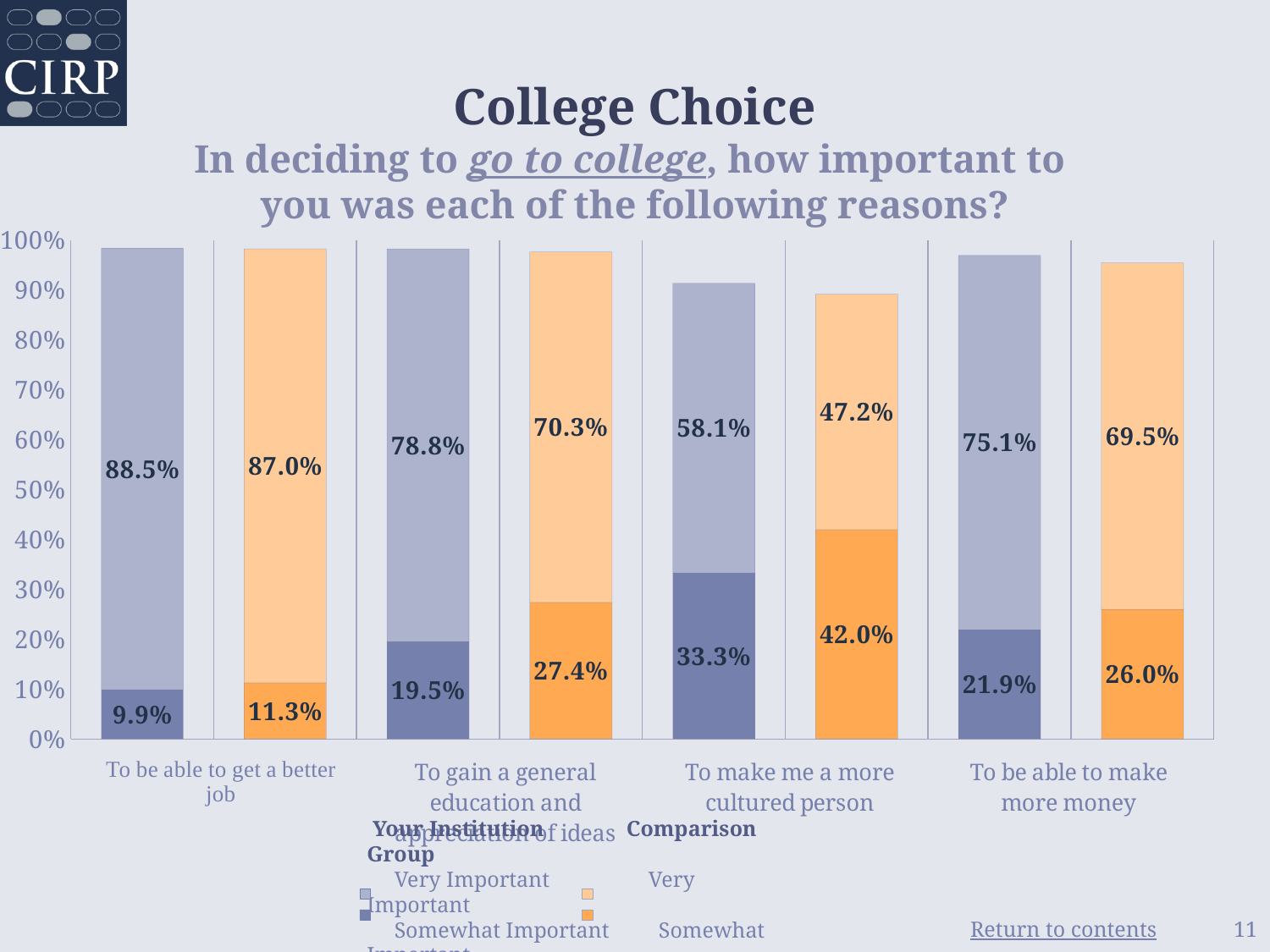
What kind of chart is shown on the slide? Stacked bar chart What is the difference between Your Institution and the Comparison Group in the Very Important percentage for 'To make me a more cultured person'? 10.9% What percentage of the Comparison Group rated 'To make me a more cultured person' as Somewhat Important? 42.0% What is the total of the Your Institution stacked bar for 'To be able to make more money'? 97.0% For 'To gain a general education and appreciation of ideas', which group has the larger Somewhat Important percentage, Your Institution or the Comparison Group? Comparison Group What is the Very Important percentage for the Comparison Group on 'To be able to make more money'? 69.5% What is the total of the Comparison Group stacked bar for 'To make me a more cultured person'? 89.2% How many reasons (categories) are shown on the x axis? 4 Which reason has the highest Very Important percentage for Your Institution? To be able to get a better job What percentage of Your Institution students rated 'To be able to get a better job' as Very Important? 88.5% How many entries does the legend list? 4 Which reason has the lowest Very Important percentage for the Comparison Group? To make me a more cultured person